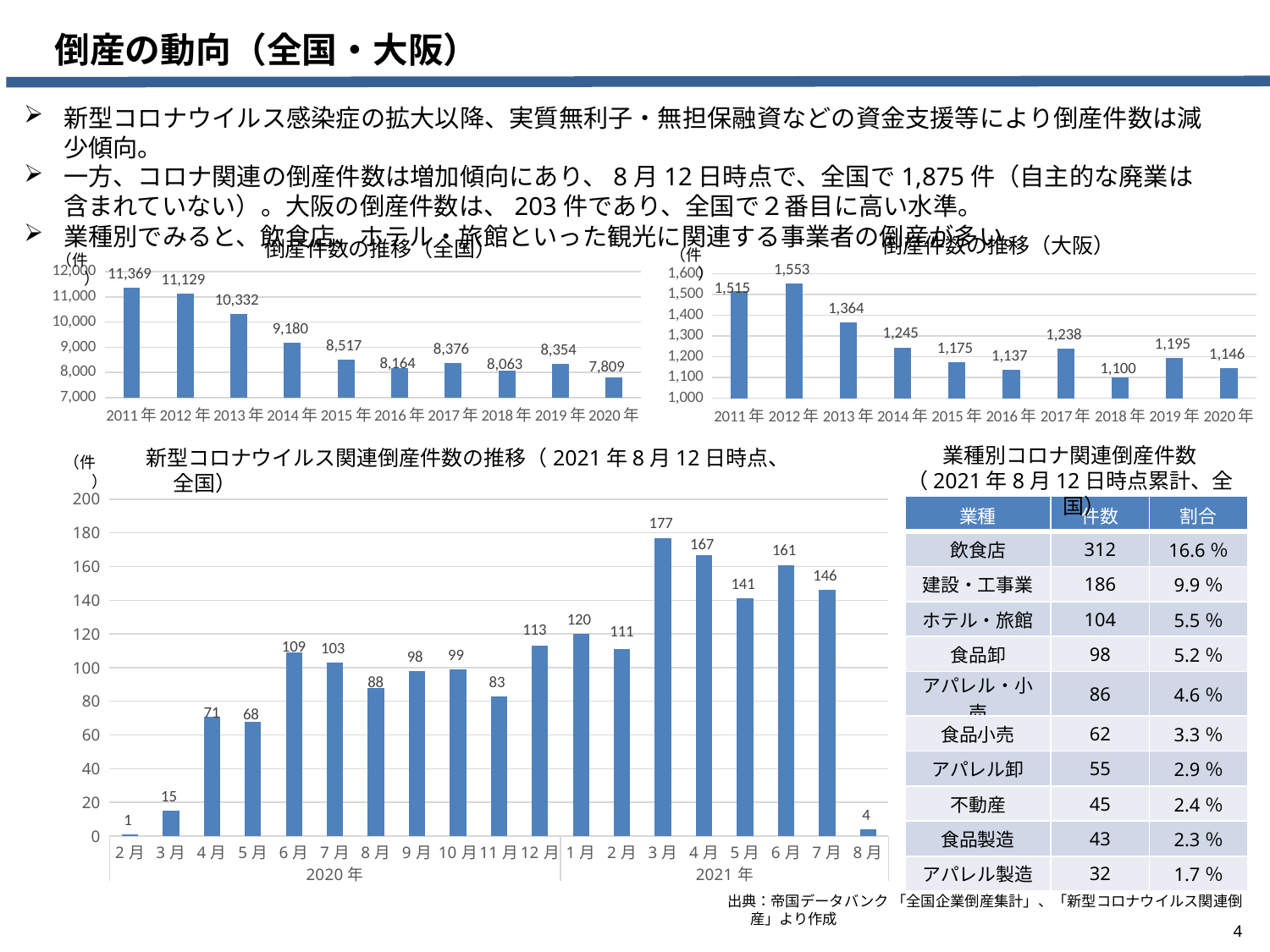
In the chart titled 倒産件数の推移（大阪）, what is the difference between the values for 2013年 and 2014年? 119 In the chart titled 新型コロナウイルス関連倒産件数の推移, what is the value for 2月 of 2020年? 1 In the chart titled 倒産件数の推移（全国）, which year has the highest value? 2011年 What kind of chart is the chart titled 新型コロナウイルス関連倒産件数の推移? Bar chart In the chart titled 新型コロナウイルス関連倒産件数の推移, what is the value for 3月 of 2021年? 177 In the chart titled 倒産件数の推移（大阪）, which year has the lowest value? 2018年 In the chart titled 倒産件数の推移（大阪）, what is the value for 2012年? 1,553 In the chart titled 倒産件数の推移（全国）, what is the difference between the values for 2011年 and 2012年? 240 In the chart titled 倒産件数の推移（大阪）, which is larger, the value for 2017年 or the value for 2019年? 2017年 In the chart titled 新型コロナウイルス関連倒産件数の推移, how many months are plotted? 19 In the chart titled 倒産件数の推移（全国）, how many years are plotted? 10 In the chart titled 倒産件数の推移（全国）, what is the value for 2020年? 7,809